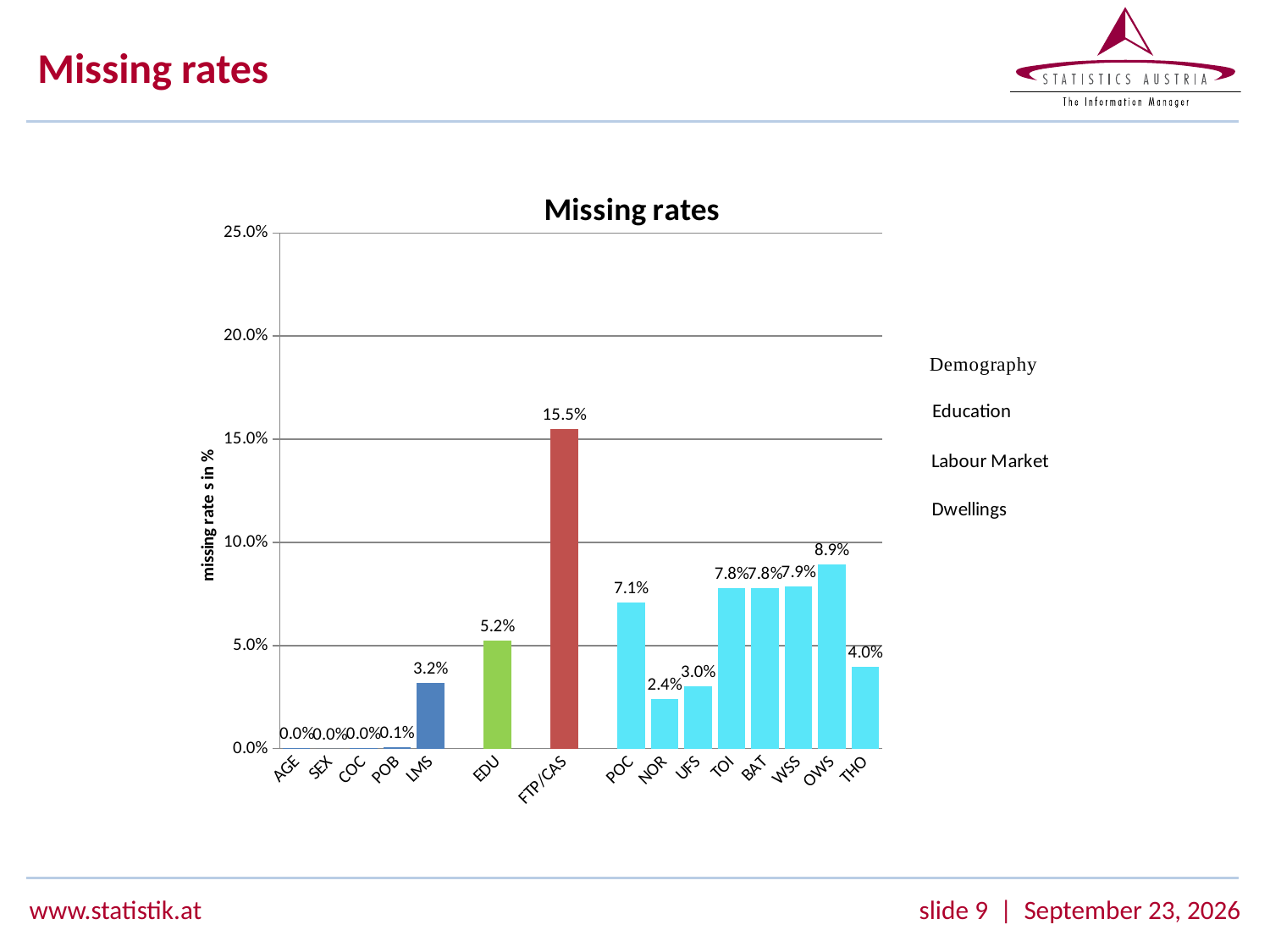
What is the missing rate for EDU? 5.2% Which category has the highest missing rate? FTP/CAS Which has a higher missing rate, POC or THO? POC How many series does the legend list? 4 What kind of chart is shown on the slide? bar chart What is the missing rate for FTP/CAS? 15.5% Is the value for LMS greater or less than 5.0%? less What is the missing rate for OWS? 8.9% What is the difference between the missing rates for FTP/CAS and OWS? 6.6% What is the label of the y axis? missing rate s in % What is the missing rate for NOR? 2.4% How many categories are shown on the x axis? 15